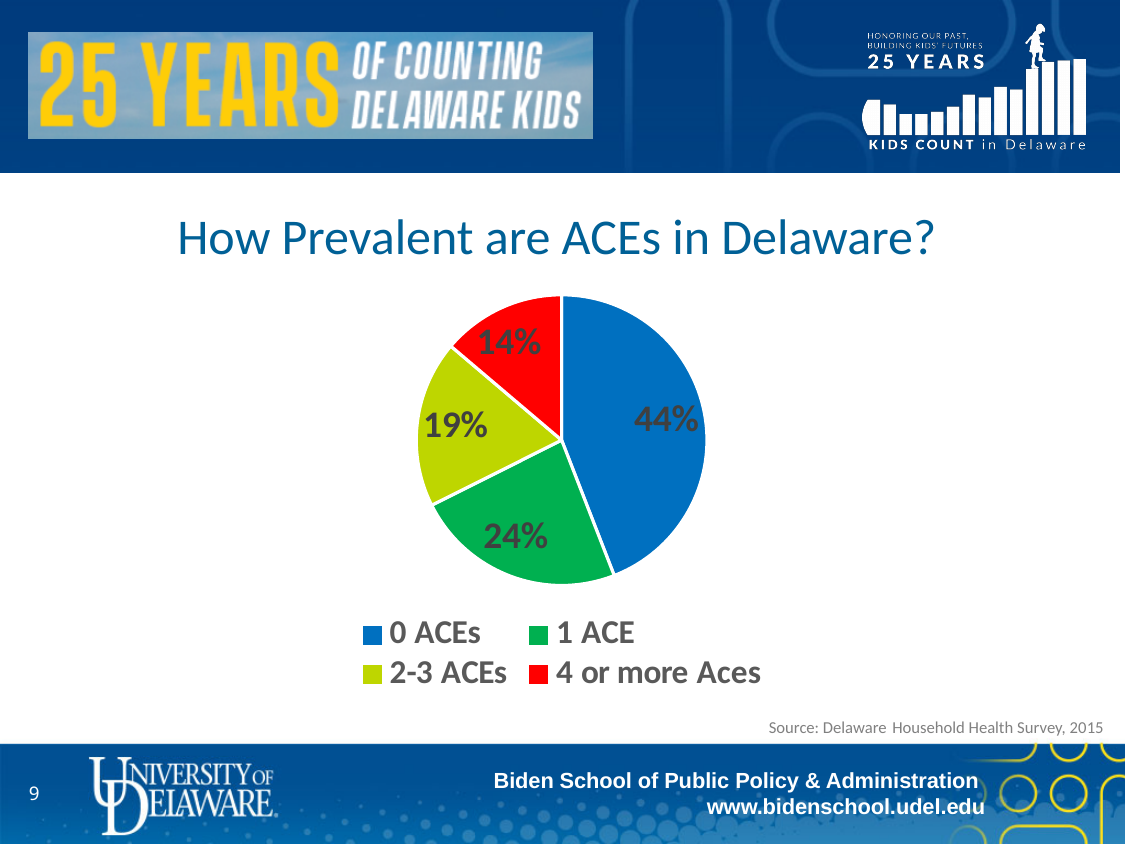
What share of the pie is labelled for 4 or more Aces? 14% What colour is the slice for 1 ACE? green What share of the pie is labelled for 1 ACE? 24% What share of the pie is labelled for 2-3 ACEs? 19% What is the difference in percentage points between the 0 ACEs slice and the 1 ACE slice? 20 Which slice is larger, 2-3 ACEs or 4 or more Aces? 2-3 ACEs Which category has the smallest slice of the pie? 4 or more Aces What kind of chart is shown on the slide? pie chart What is the title of the chart? How Prevalent are ACEs in Delaware? What share of the pie is labelled for 0 ACEs? 44% Which category has the largest slice of the pie? 0 ACEs How many slices does the pie chart have? 4